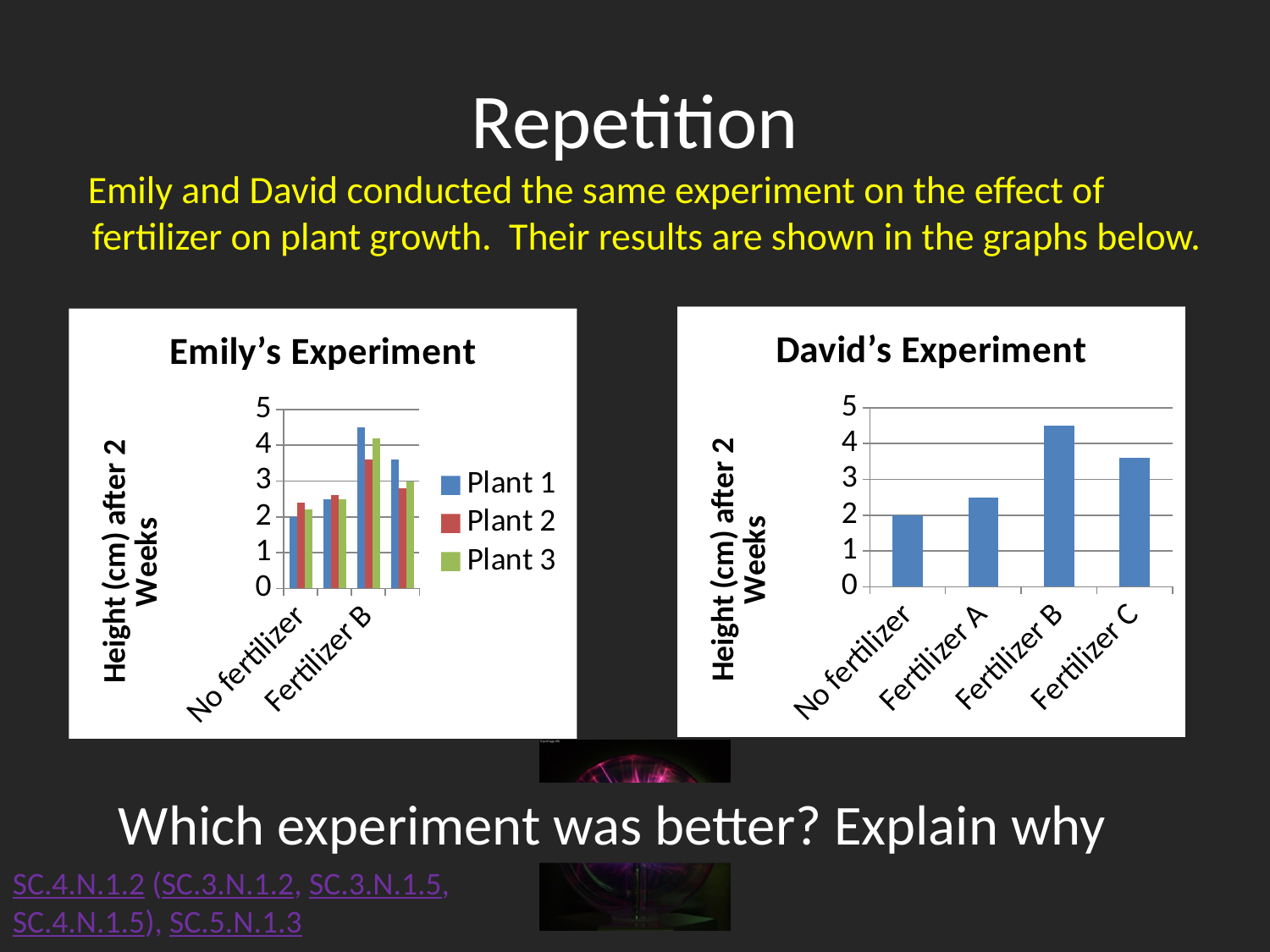
In David's Experiment, is the value for Fertilizer B greater or less than 4? greater In David's Experiment, how many fertilizer categories are shown on the x axis? 4 In David's Experiment, which category has the shortest bar? No fertilizer What is the y-axis title of Emily's Experiment? Height (cm) after 2 Weeks In Emily's Experiment, is the Plant 1 value for Fertilizer B greater or less than 4? greater What kind of chart is David's Experiment? bar chart In David's Experiment, which category has the tallest bar? Fertilizer B In David's Experiment, which is larger, the bar for Fertilizer B or the bar for Fertilizer C? Fertilizer B What are the legend entries in Emily's Experiment? Plant 1, Plant 2, Plant 3 In David's Experiment, what is the height for No fertilizer? 2 In David's Experiment, is the value for Fertilizer A greater or less than 3? less How many series does the legend of Emily's Experiment list? 3